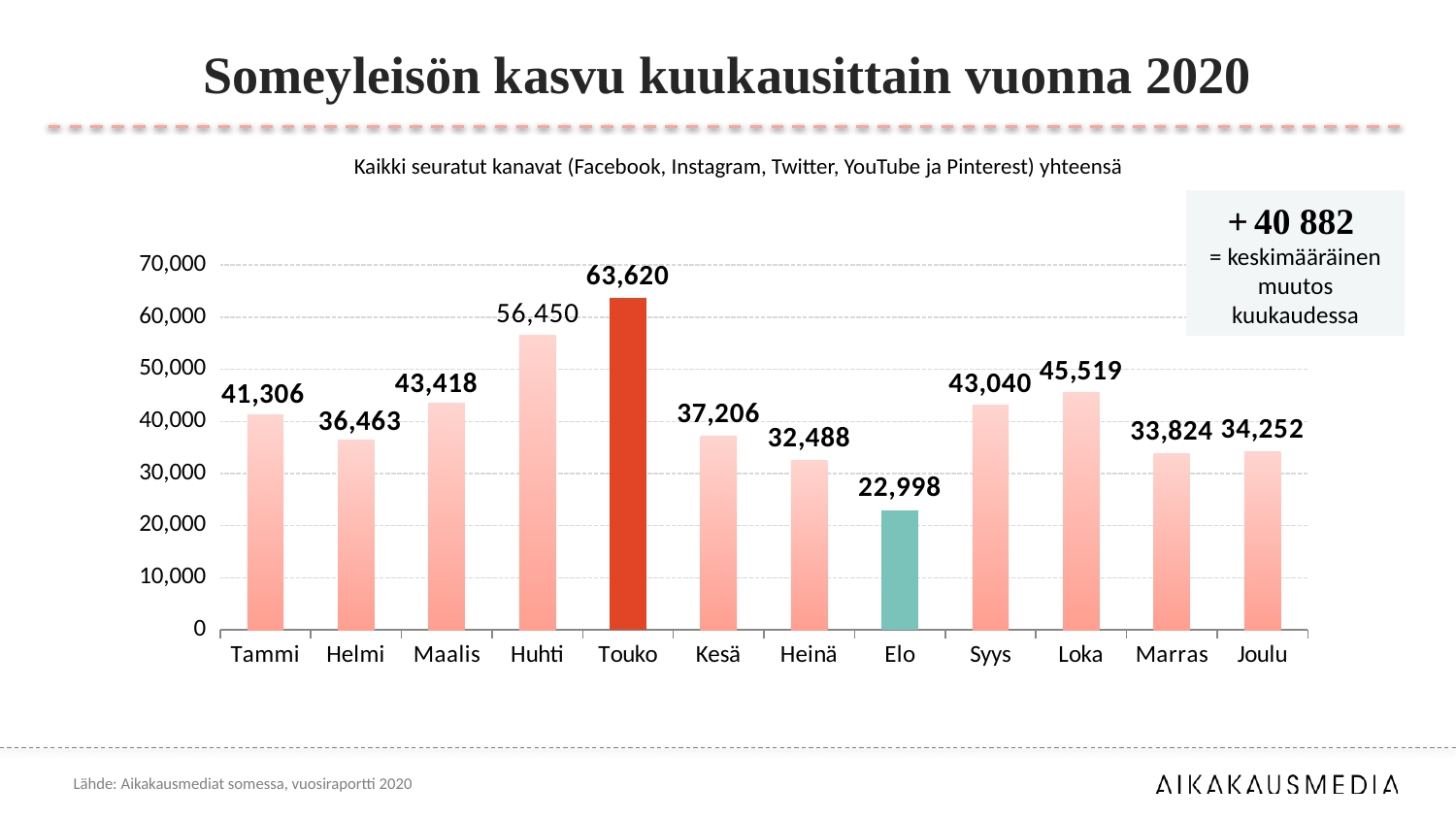
What is the difference between the values for Touko and Elo? 40,622 What is the value for Elo? 22,998 How many months are shown on the x axis? 12 What is the value for Huhti? 56,450 What is the value for Marras? 33,824 Which month has the highest value? Touko What is the difference between the values for Huhti and Tammi? 15,144 What kind of chart is shown on the slide? Bar chart What is the value for Touko? 63,620 Which month has the lowest value? Elo Which is larger, the value for Loka or the value for Syys? Loka What is the title of the slide? Someyleisön kasvu kuukausittain vuonna 2020